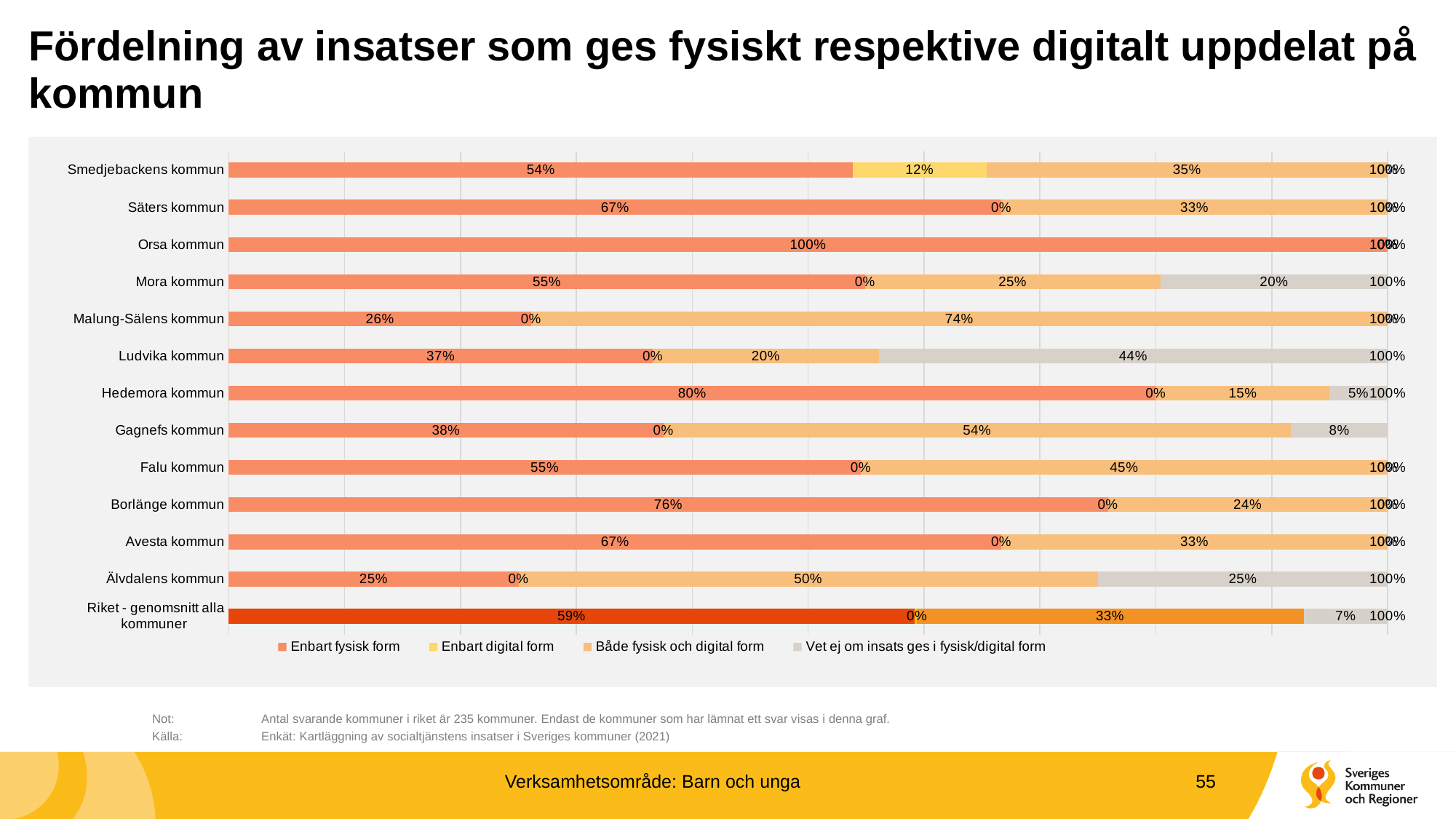
Which has a larger 'Enbart fysisk form' value, Borlänge kommun or Avesta kommun? Borlänge kommun What is the value of 'Enbart fysisk form' for 'Riket - genomsnitt alla kommuner'? 59% How many series does the legend list? 4 Which series is shown in yellow in the legend? Enbart digital form What is the value of 'Enbart digital form' for Smedjebackens kommun? 12% What is the difference in 'Enbart fysisk form' between Hedemora kommun (80%) and Gagnefs kommun (38%)? 42 percentage points How many categories (rows) are plotted in the chart? 13 What kind of chart is shown on the slide? Stacked bar chart Which municipality has the highest value for 'Vet ej om insats ges i fysisk/digital form'? Ludvika kommun What is the value of 'Enbart fysisk form' for Orsa kommun? 100% What is the value of 'Både fysisk och digital form' for Malung-Sälens kommun? 74% Which category has the highest value for 'Enbart fysisk form'? Orsa kommun